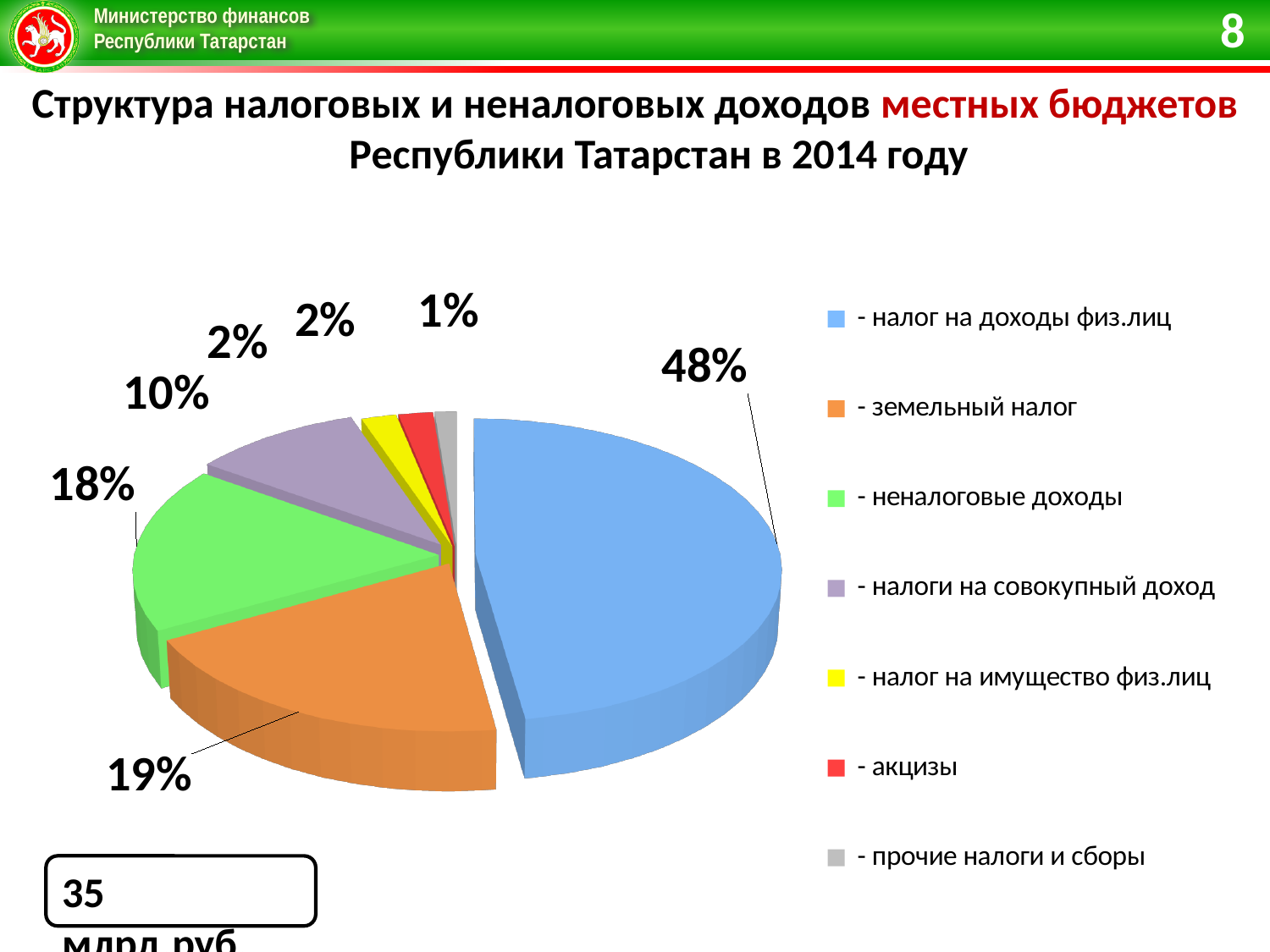
What share of the pie does налоги на совокупный доход account for? 10% Which category has the largest slice of the pie? налог на доходы физ.лиц How many categories does the pie chart show? 7 What share of the pie does земельный налог account for? 19% What colour is the slice for акцизы? red By how many percentage points does the share of налог на доходы физ.лиц exceed the share of земельный налог? 29 percentage points What share of the pie does налог на доходы физ.лиц account for? 48% Which category has the smallest slice of the pie? прочие налоги и сборы Which is larger: the share of земельный налог or the share of неналоговые доходы? земельный налог What share of the pie does прочие налоги и сборы account for? 1% What share of the pie does неналоговые доходы account for? 18% What type of chart is shown on the slide? pie chart